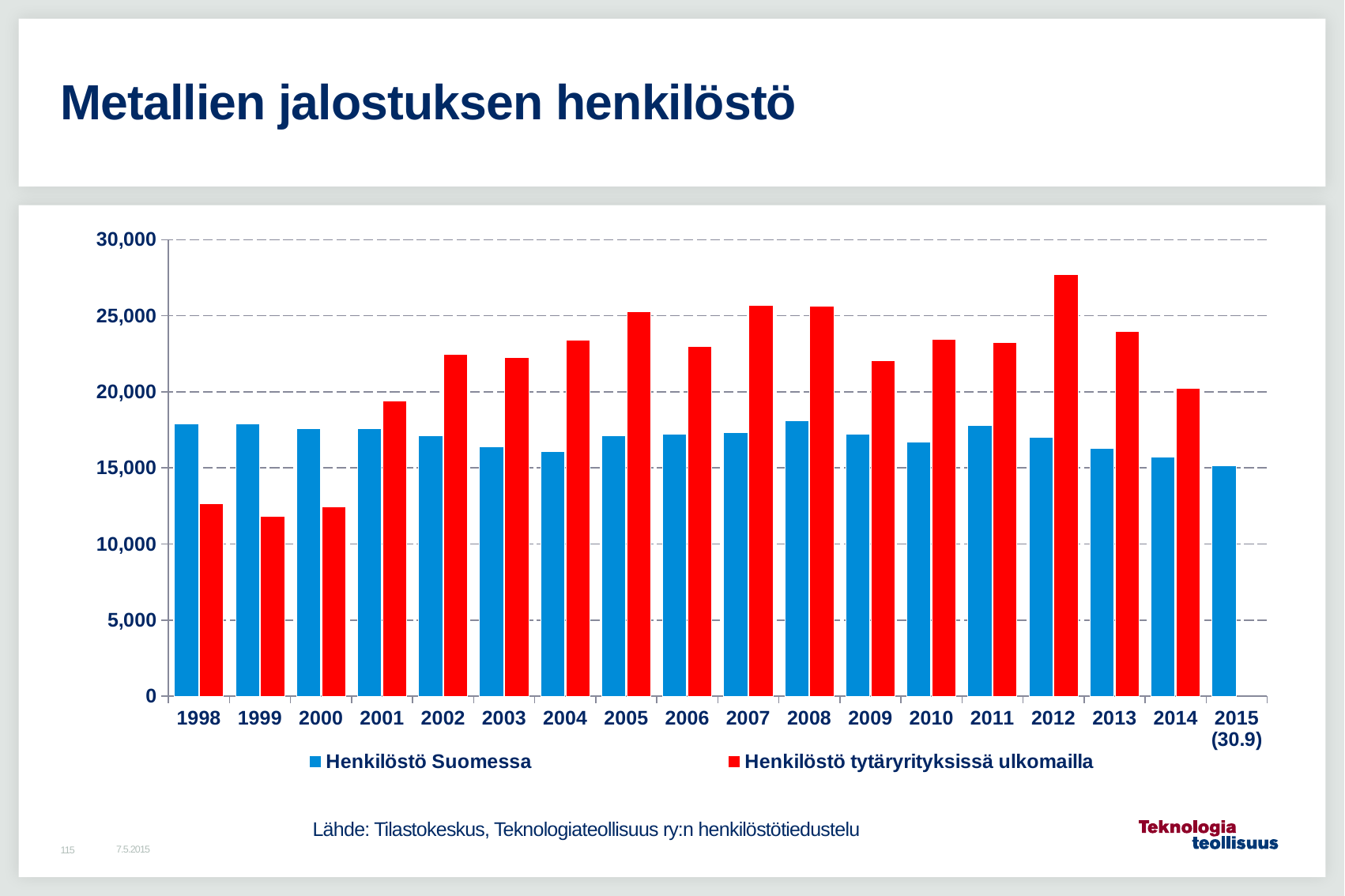
How many years (categories) are shown on the x axis? 18 In which year is the value for Henkilöstö tytäryrityksissä ulkomailla the lowest? 1999 Is the value for Henkilöstö tytäryrityksissä ulkomailla in 1998 greater or less than 15,000? less Which colour represents Henkilöstö tytäryrityksissä ulkomailla in the chart? red How many series does the legend list? 2 In 2007, which is larger: Henkilöstö Suomessa or Henkilöstö tytäryrityksissä ulkomailla? Henkilöstö tytäryrityksissä ulkomailla Is the value for Henkilöstö tytäryrityksissä ulkomailla in 2012 greater or less than 25,000? greater What type of chart is shown on the slide? bar chart In 1999, which is larger: Henkilöstö Suomessa or Henkilöstö tytäryrityksissä ulkomailla? Henkilöstö Suomessa In which year is the value for Henkilöstö Suomessa the lowest? 2015 (30.9) Is the value for Henkilöstö Suomessa in 2014 greater or less than 15,000? greater In which year is the value for Henkilöstö tytäryrityksissä ulkomailla the highest? 2012